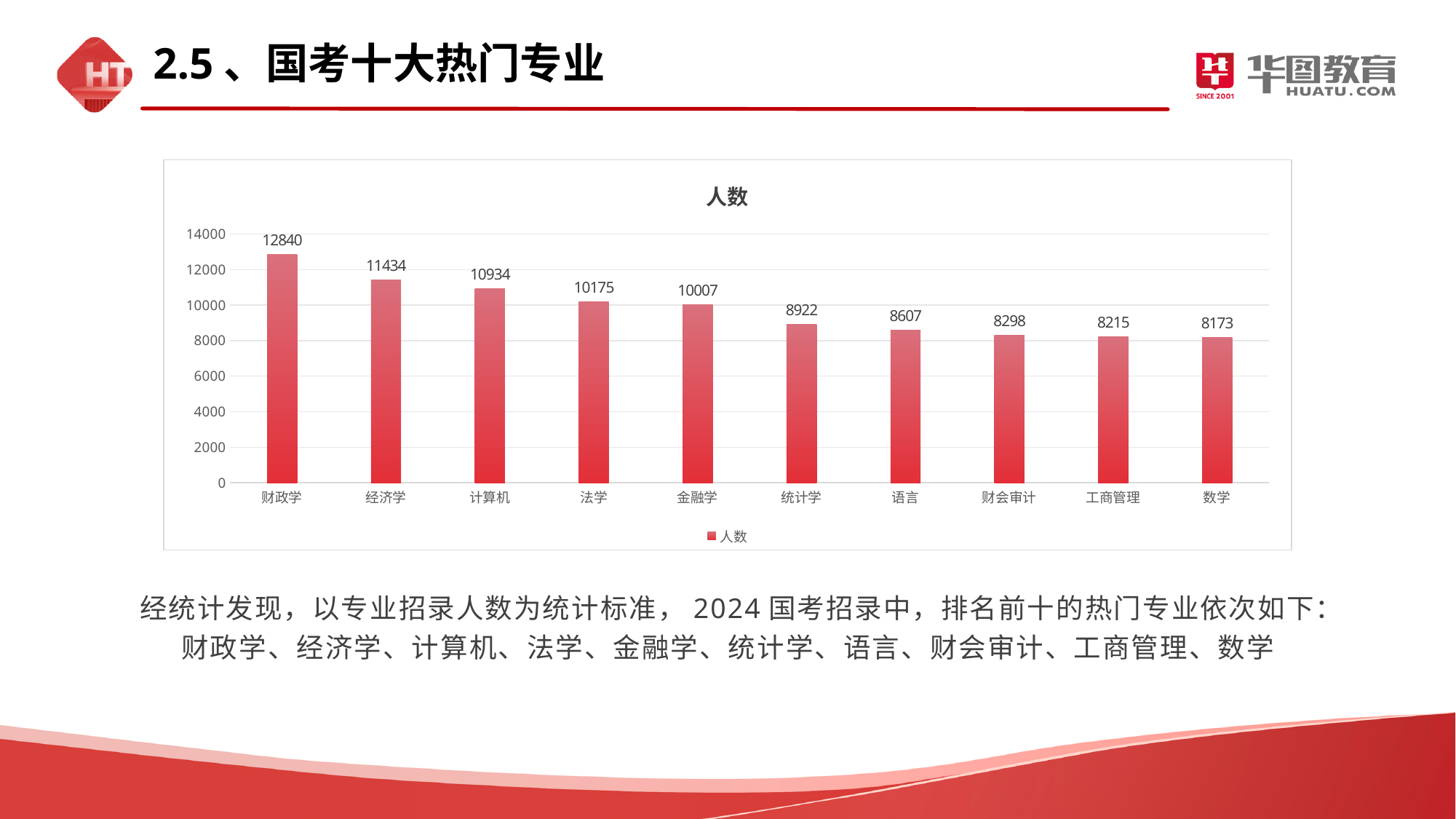
What kind of chart is shown? bar chart Which category has the lowest value? 数学 What is the value for 金融学? 10007 How many series does the legend list? 1 How many categories are shown in the chart? 10 Which is larger, the value for 计算机 or the value for 语言? 计算机 What is the difference between the values for 财政学 and 经济学? 1406 What is the value for 财政学? 12840 What is the difference between the values for 法学 and 统计学? 1253 What is the value for 工商管理? 8215 Which category has the highest value? 财政学 Do the values rise or fall from left to right along the x axis? fall